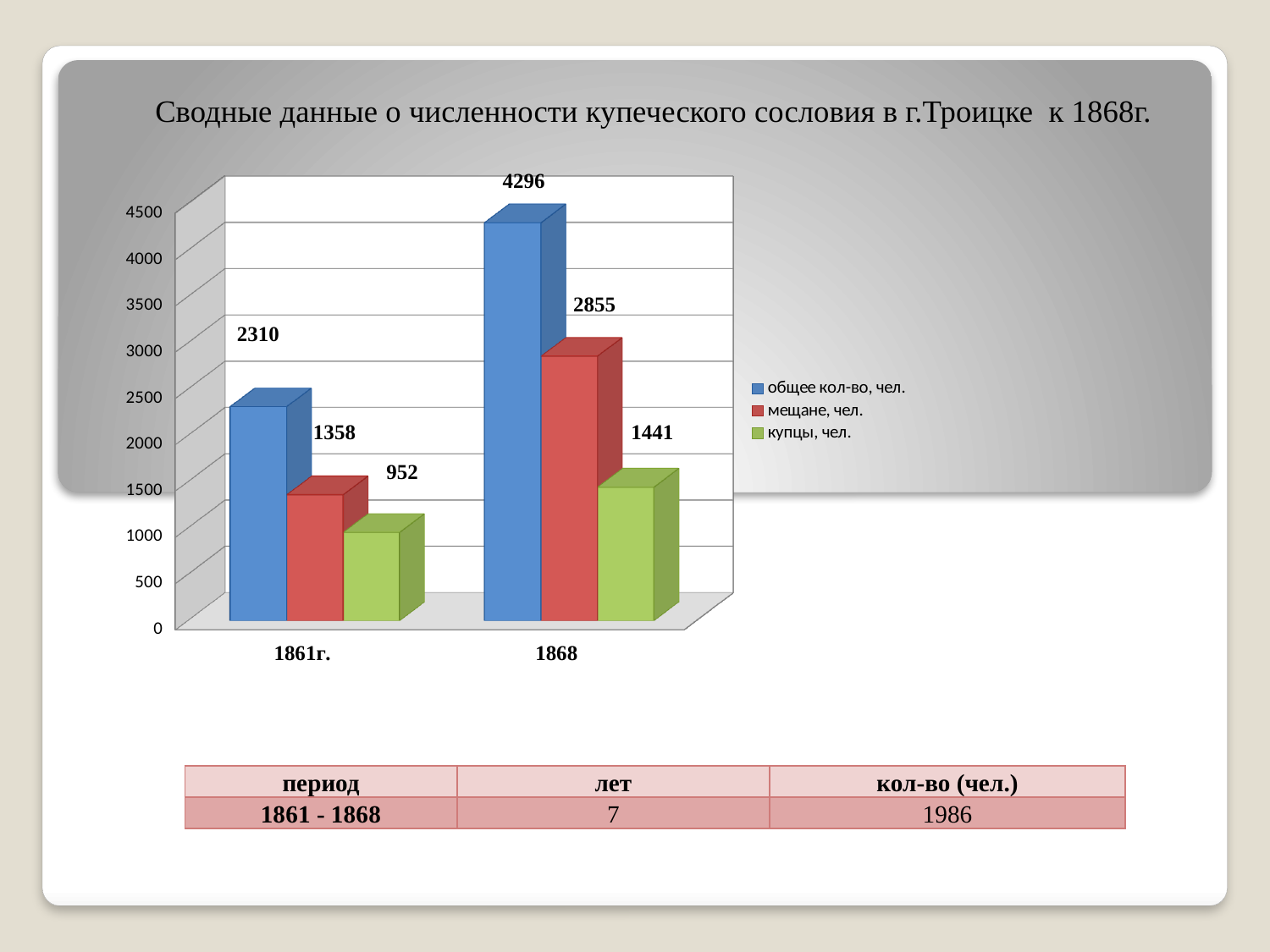
What is the value for "общее кол-во, чел." in 1868? 4296 What kind of chart is shown on the slide? bar chart Which series has the lowest value in 1861г.? купцы, чел. What is the difference between the "общее кол-во, чел." values for 1868 and 1861г.? 1986 What is the difference between the "мещане, чел." values for 1868 and 1861г.? 1497 Which series has the highest value in 1868? общее кол-во, чел. What is the value for "мещане, чел." in 1861г.? 1358 How many categories are shown on the x axis? 2 What is the value for "купцы, чел." in 1868? 1441 What is the value for "общее кол-во, чел." in 1861г.? 2310 How many series does the legend list? 3 Which is larger: "купцы, чел." in 1868 or "мещане, чел." in 1861г.? купцы, чел. in 1868